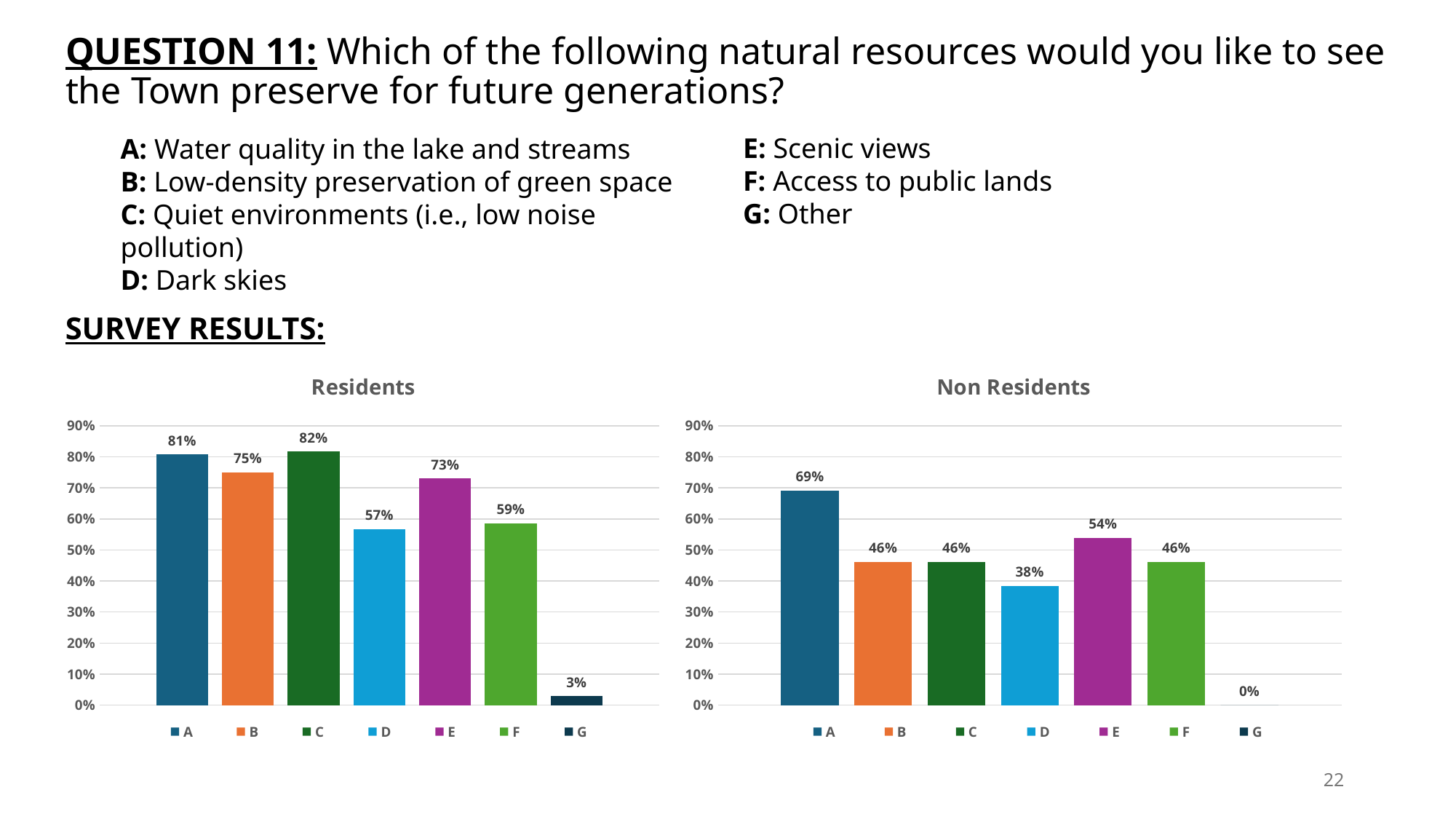
How many entries does the legend of the Non Residents chart list? 7 In the Non Residents chart, which category has the highest value? A What kind of chart is the Residents chart? bar chart In the Non Residents chart, what is the value for category G? 0% In the Residents chart, what is the value for category C? 82% In the Residents chart, which category has the lowest value? G In the Residents chart, which is larger, the value for B or the value for E? B In the Non Residents chart, is the value for D greater or less than 40%? less In the Non Residents chart, what is the value for category A? 69% In the Non Residents chart, what is the difference between the values for E and D? 16% In the Residents chart, what is the difference between the values for A and D? 24% How many categories are shown in the Residents chart? 7